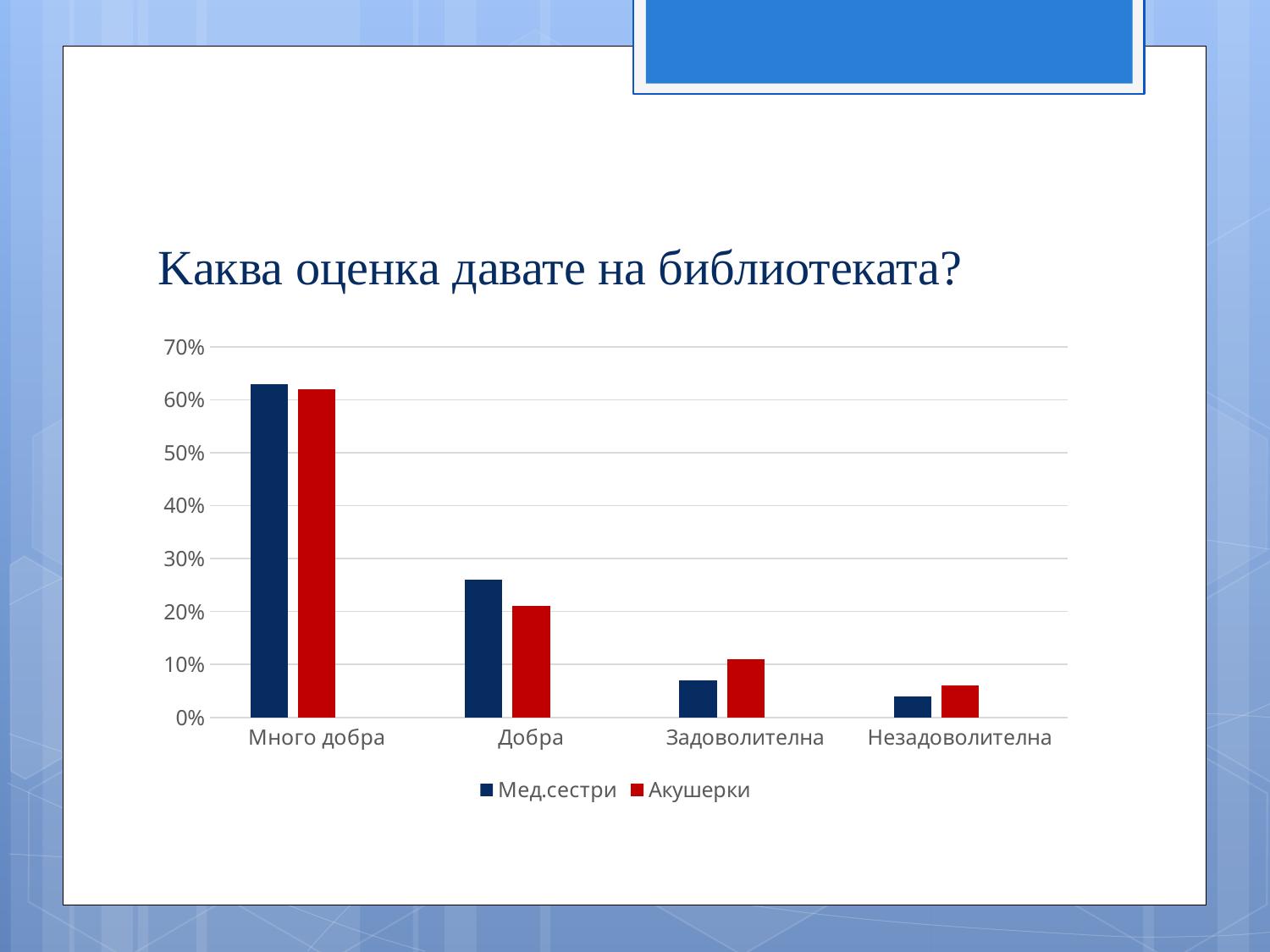
Which category has the lowest value for Мед.сестри? Незадоволителна Which category has the highest value for Мед.сестри? Много добра What kind of chart is shown on the slide? bar chart Is the value for Мед.сестри in Много добра greater or less than 60%? greater For Задоволителна, which series has the larger value, Мед.сестри or Акушерки? Акушерки Do the values for Мед.сестри rise or fall from Много добра to Незадоволителна along the x axis? fall How many series does the legend list? 2 Which category has the lowest value for Акушерки? Незадоволителна What is the title of the chart? Каква оценка давате на библиотеката? How many categories are shown on the x axis? 4 Is the value for Мед.сестри in Незадоволителна greater or less than 10%? less For Добра, which series has the larger value, Мед.сестри or Акушерки? Мед.сестри